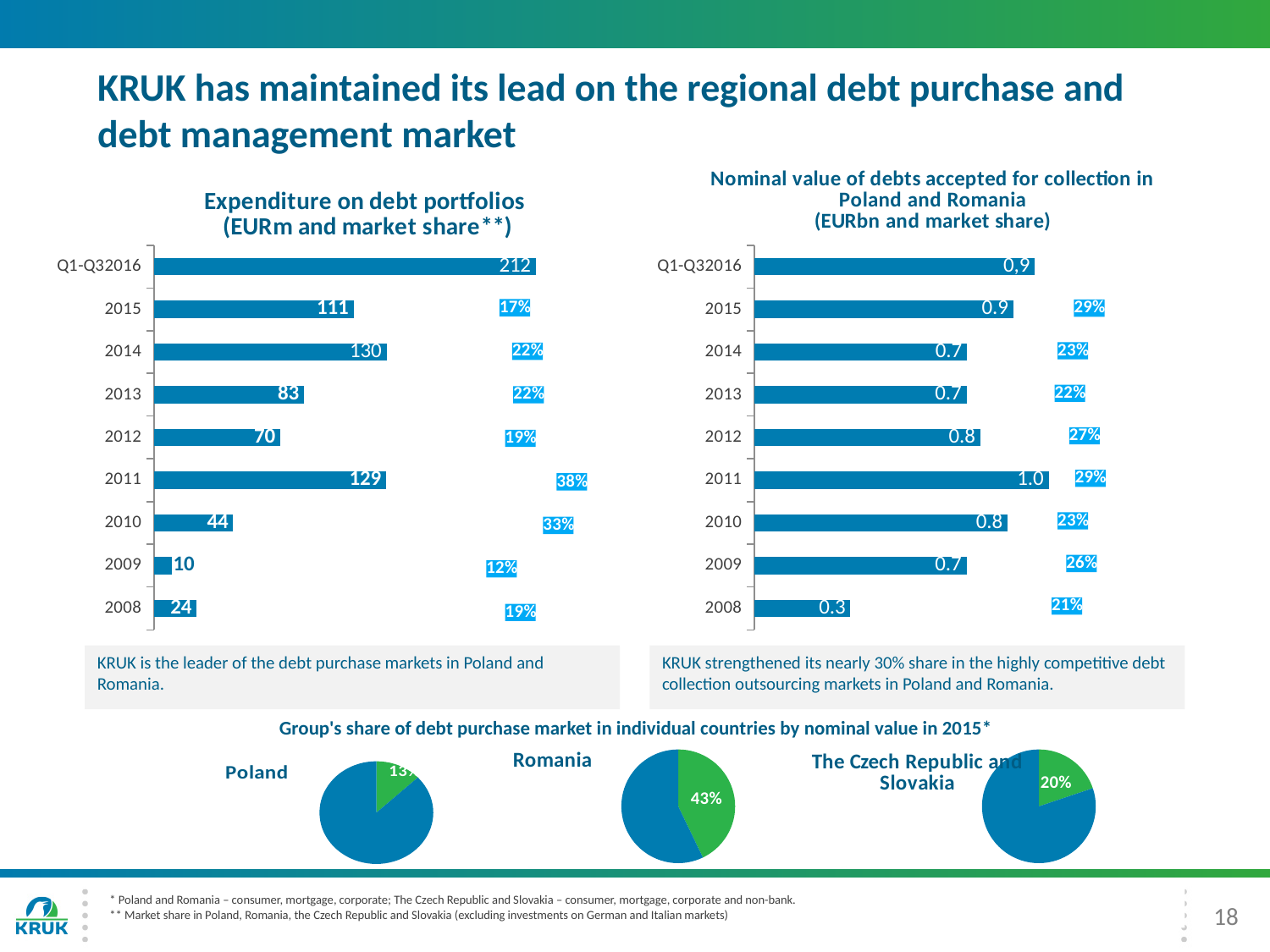
In the Romania pie chart at the bottom of the slide, what share is labelled on the green slice? 43% In the 'Expenditure on debt portfolios' chart, which year has the lowest value? 2009 In the 'Expenditure on debt portfolios' chart, which year has the highest value? Q1-Q32016 In the 'Expenditure on debt portfolios' chart, what is the difference between the values for 2014 and 2013? 47 In the 'Expenditure on debt portfolios' chart, what market share is shown for 2011? 38% In the 'Nominal value of debts accepted for collection in Poland and Romania' chart, which year has the lowest value? 2008 In the 'Nominal value of debts accepted for collection in Poland and Romania' chart, how many categories are plotted? 9 In the 'Expenditure on debt portfolios' chart, what is the value for Q1-Q32016? 212 In the 'Nominal value of debts accepted for collection in Poland and Romania' chart, what is the value for 2011? 1.0 In the 'Expenditure on debt portfolios' chart, what is the value for 2009? 10 In the 'Nominal value of debts accepted for collection in Poland and Romania' chart, what market share is shown for 2015? 29% What kind of chart is the 'Expenditure on debt portfolios' chart? Bar chart